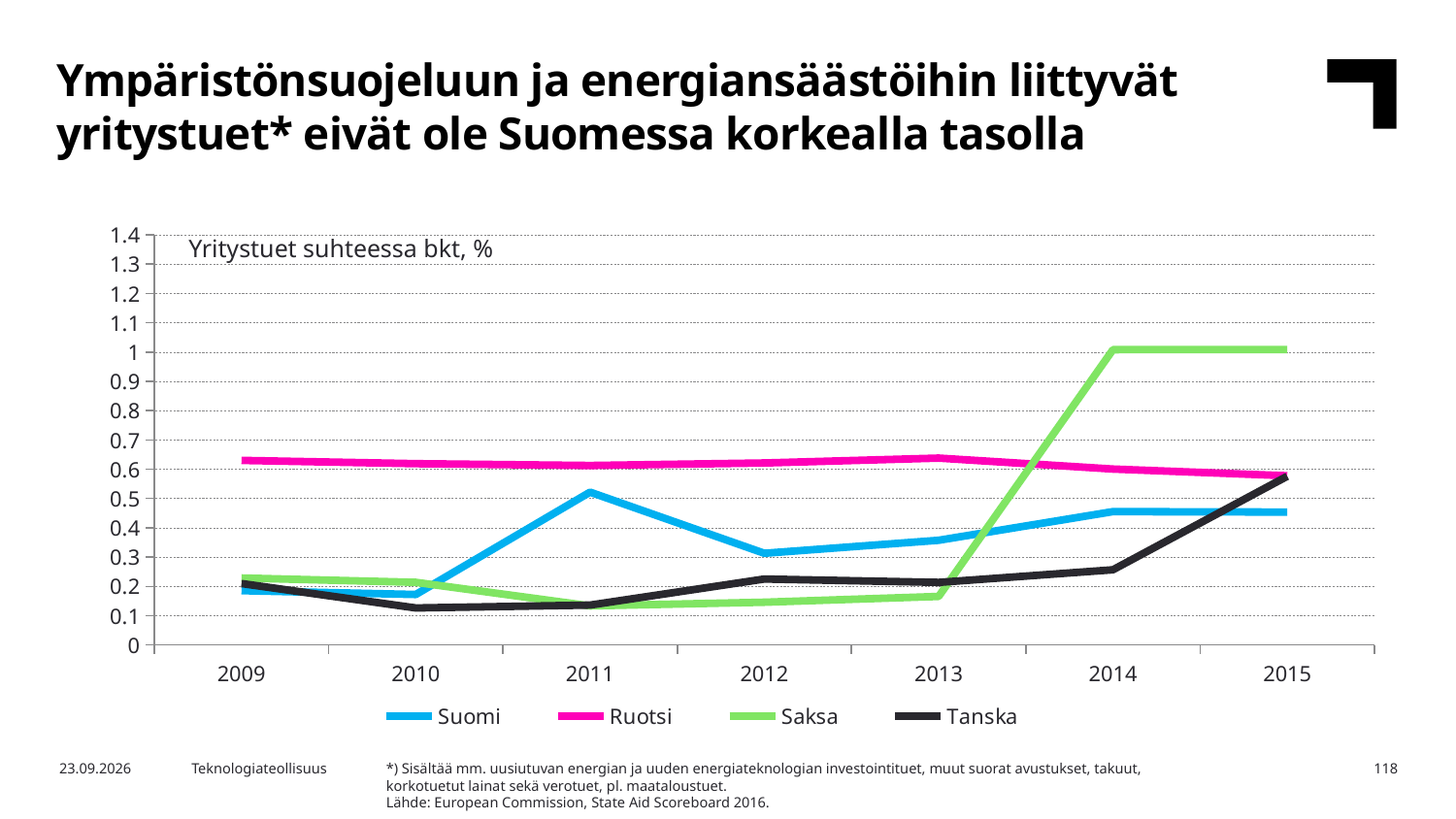
In 2011, which is larger: the value for Suomi or the value for Tanska? Suomi What is the title printed inside the chart area? Yritystuet suhteessa bkt, % Which series has the highest value in 2009? Ruotsi Is the value for Suomi in 2012 greater or less than 0.4? less Does the value for Saksa rise or fall from 2013 to 2014? Rise Is the value for Saksa in 2014 greater or less than 0.9? greater Which series has the highest value in 2015? Saksa Which series has the lowest value in 2010? Tanska How many years are shown on the x axis? 7 What type of chart is shown on the slide? Line chart How many series does the legend list? 4 In 2012, which is larger: the value for Ruotsi or the value for Suomi? Ruotsi